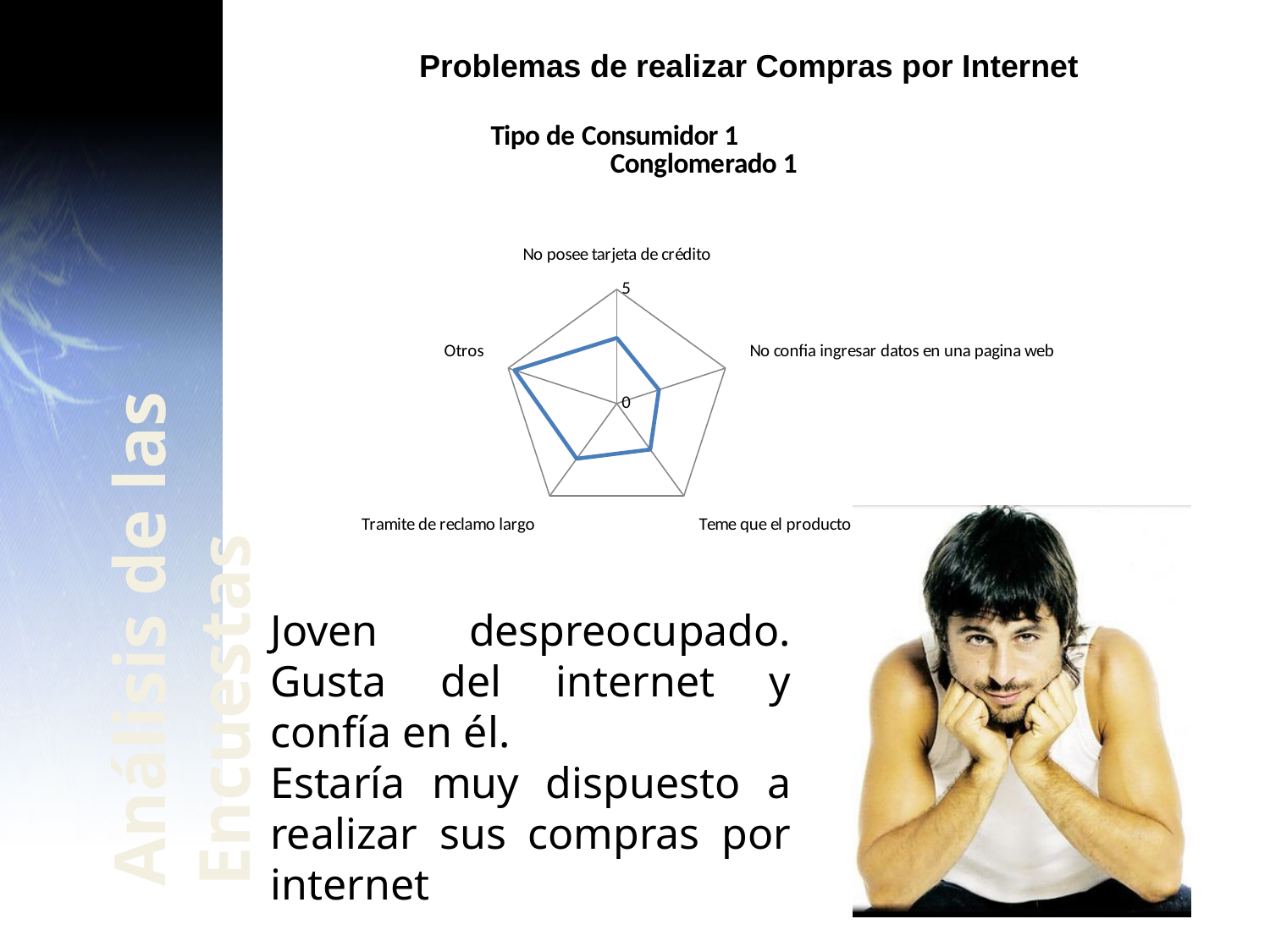
Which category has the highest value in the radar chart? Otros Is the value for No confia ingresar datos en una pagina web greater or less than 5? less How many categories (axes) does the radar chart have? 5 Which category has the lowest value in the radar chart? No confia ingresar datos en una pagina web Which has a larger value: Otros or No posee tarjeta de crédito? Otros Is the value for No posee tarjeta de crédito greater or less than 5? less Which has a larger value: Otros or No confia ingresar datos en una pagina web? Otros What kind of chart is shown on the slide? Radar chart What is the maximum value shown on the chart's axis scale? 5 How many data series are plotted on the radar chart? 1 What is the title of the chart? Tipo de Consumidor 1 Conglomerado 1 Which has a larger value: Tramite de reclamo largo or No confia ingresar datos en una pagina web? Tramite de reclamo largo